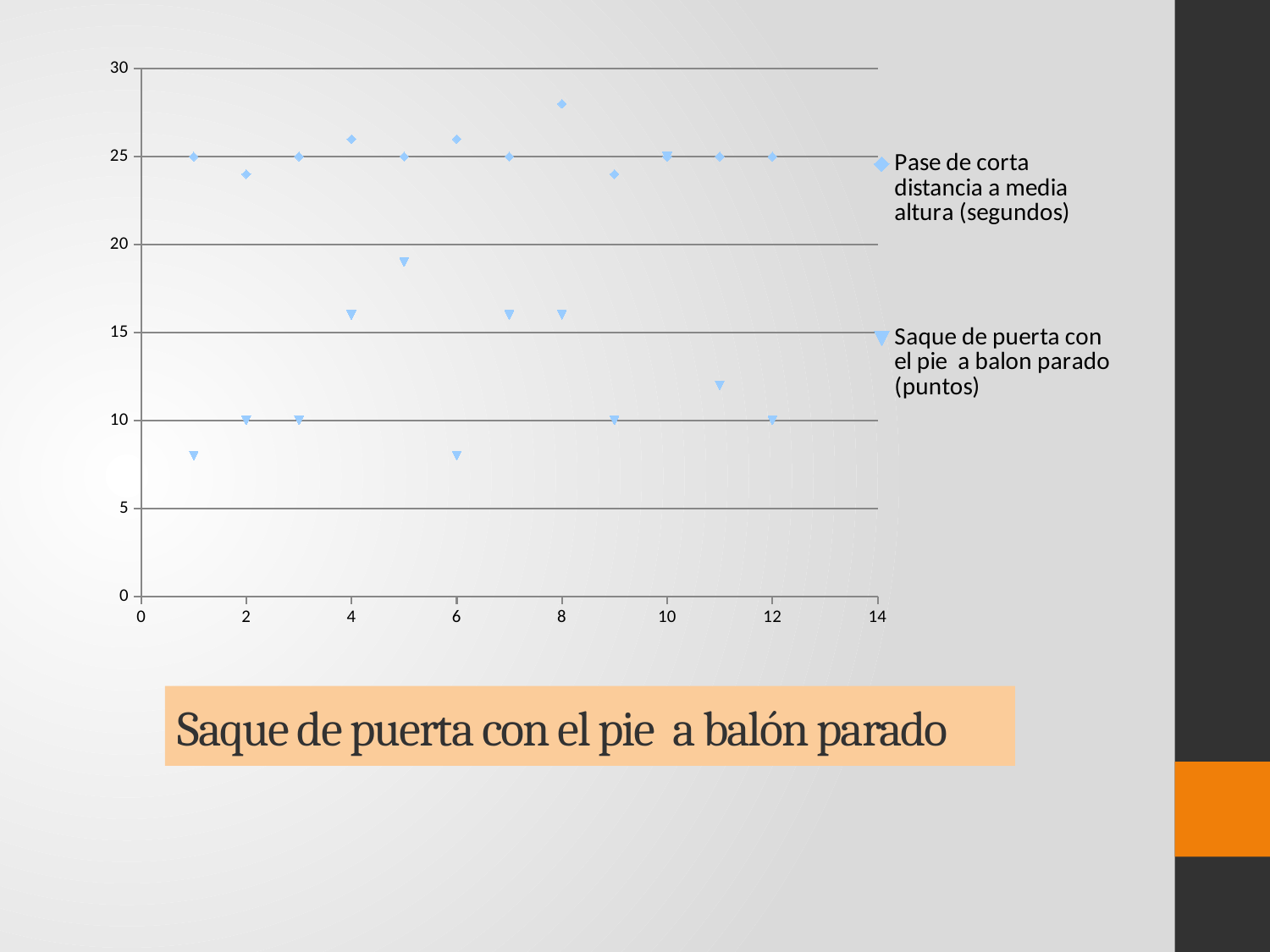
At which x value does the 'Pase de corta distancia a media altura (segundos)' series reach its highest point? 8 What is the value of the 'Saque de puerta con el pie a balon parado (puntos)' series at x = 2? 10 What kind of chart is shown on the slide? scatter chart Is the value of the 'Saque de puerta con el pie a balon parado (puntos)' series at x = 5 greater or less than 15? greater Is the value of the 'Saque de puerta con el pie a balon parado (puntos)' series at x = 1 greater or less than 10? less How many points are plotted for the 'Pase de corta distancia a media altura (segundos)' series? 12 What is the value of the 'Pase de corta distancia a media altura (segundos)' series at x = 1? 25 Is the value of the 'Pase de corta distancia a media altura (segundos)' series at x = 8 greater or less than 25? greater What marker shape is used for the 'Saque de puerta con el pie a balon parado (puntos)' series? triangle At x = 8, which series has the larger value: 'Pase de corta distancia a media altura (segundos)' or 'Saque de puerta con el pie a balon parado (puntos)'? Pase de corta distancia a media altura (segundos) How many series does the legend list? 2 At which x value does the 'Saque de puerta con el pie a balon parado (puntos)' series reach its highest point? 10